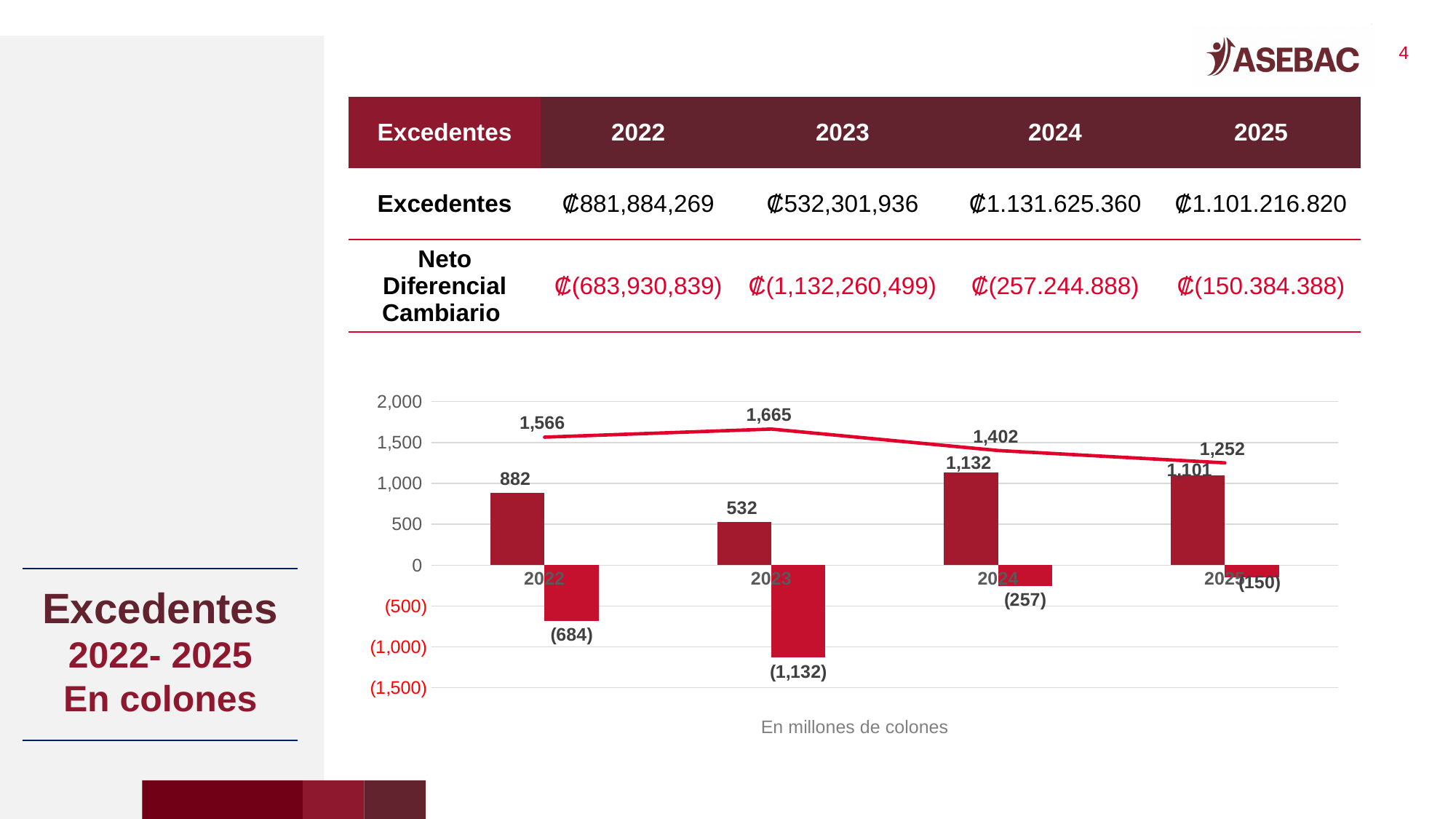
Does the line in the chart rise or fall from 2023 to 2025? fall In which year does the line reach its highest value in the chart? 2023 What unit note is printed below the chart? En millones de colones What kind of chart is shown on the slide? Combined bar and line chart What is the value of the negative (bright red) bar for 2025 in the chart? (150) What is the difference between the line values for 2023 and 2022 in the chart? 99 What is the value of the negative (bright red) bar for 2023 in the chart? (1,132) What is the value of the dark red bar for 2022 in the chart? 882 What value does the line show for 2023 in the chart? 1,665 How many years are shown on the x axis of the chart? 4 Which year has the larger dark red bar in the chart, 2024 or 2025? 2024 In which year is the dark red bar the lowest in the chart? 2023